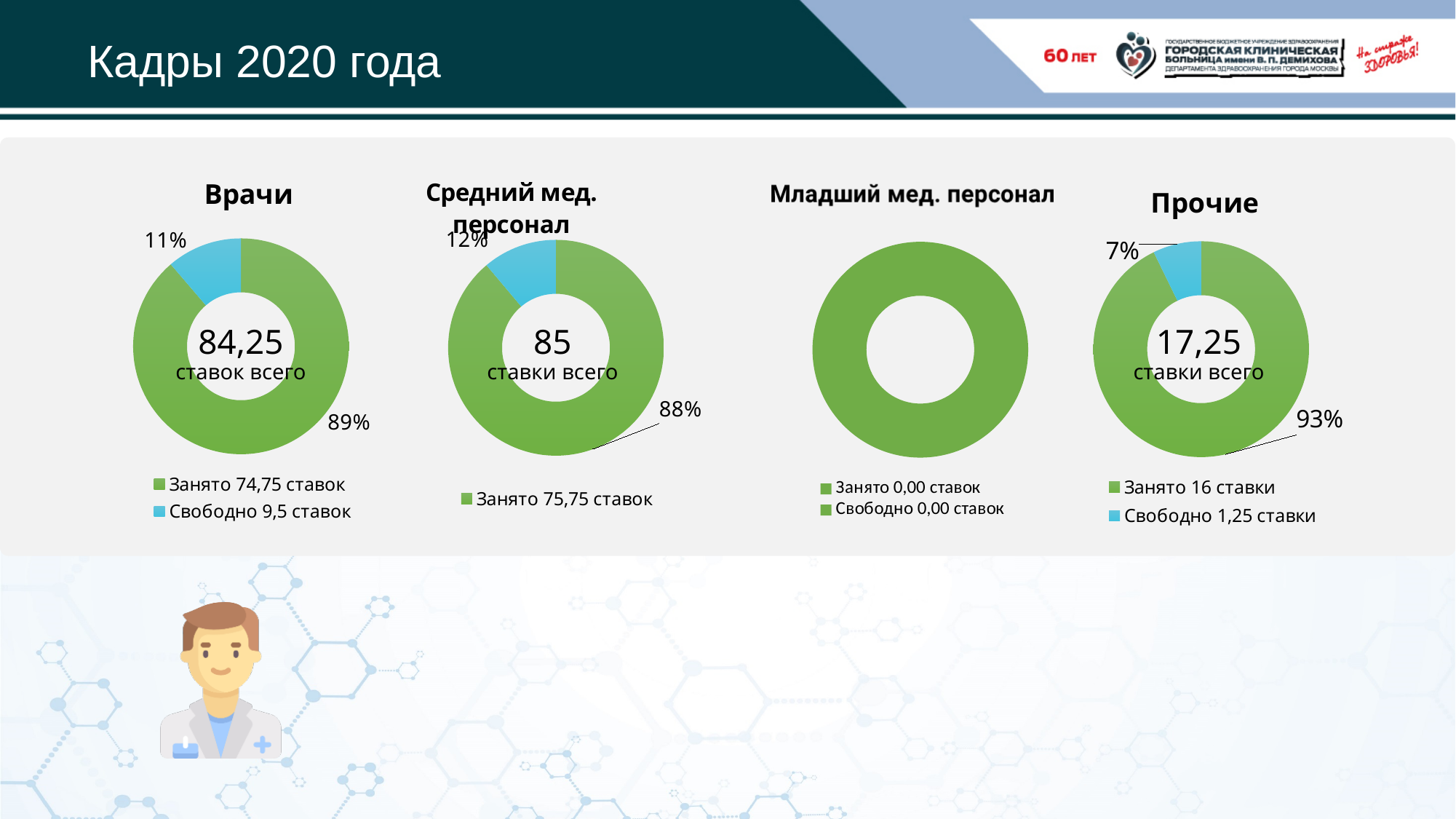
In the 'Врачи' chart, what total number of positions is shown in the centre? 84,25 In the 'Средний мед. персонал' chart, what share of positions is occupied? 88% What type of chart is used for 'Врачи'? Doughnut (pie) chart In the 'Прочие' chart, what total number of positions is shown in the centre? 17,25 In the 'Средний мед. персонал' chart, how many positions are occupied according to the legend? 75,75 ставок In the 'Врачи' chart, what share of positions is shown as occupied (Занято)? 89% In the 'Врачи' chart, what share of positions is shown as free (Свободно)? 11% In the 'Средний мед. персонал' chart, what total number of positions is shown in the centre? 85 Which chart shows the largest occupied share: 'Врачи', 'Средний мед. персонал' or 'Прочие'? Прочие In the 'Врачи' chart, how many positions are occupied according to the legend? 74,75 ставок In the 'Прочие' chart, how many positions are free according to the legend? 1,25 ставки